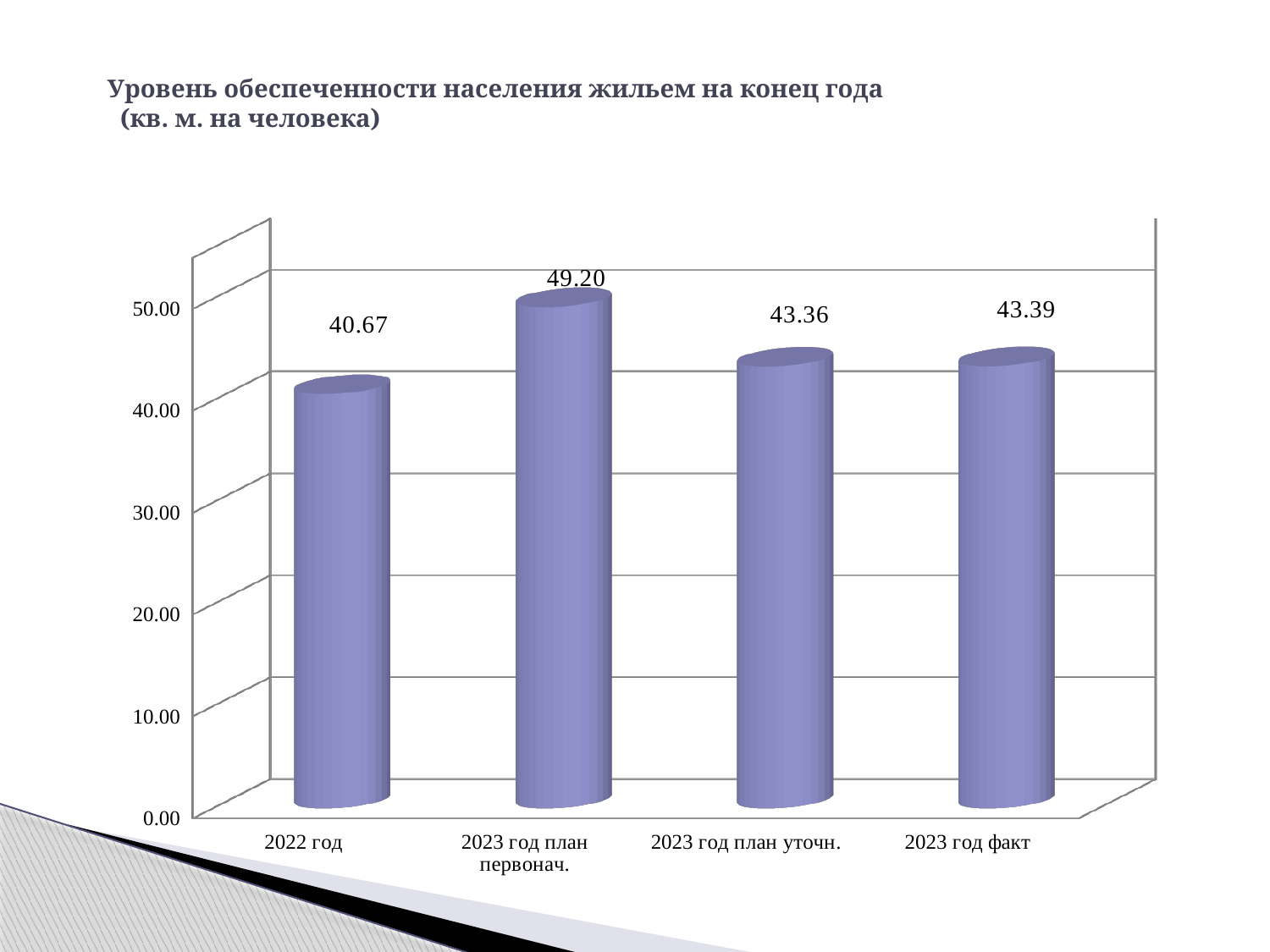
What is the difference between the values for "2023 год факт" and "2023 год план уточн."? 0.03 What is the value for "2023 год план уточн."? 43.36 Which category has the highest value? 2023 год план первонач. What is the difference between the values for "2023 год план первонач." and "2022 год"? 8.53 Which is larger, the value for "2023 год план первонач." or the value for "2023 год факт"? 2023 год план первонач. What kind of chart is shown on the slide? bar chart Which category has the lowest value? 2022 год How many categories are shown on the x axis? 4 What is the value for "2023 год факт"? 43.39 What is the value for "2022 год"? 40.67 Is the value for "2022 год" greater or less than 50.00? less What is the value for "2023 год план первонач."? 49.20